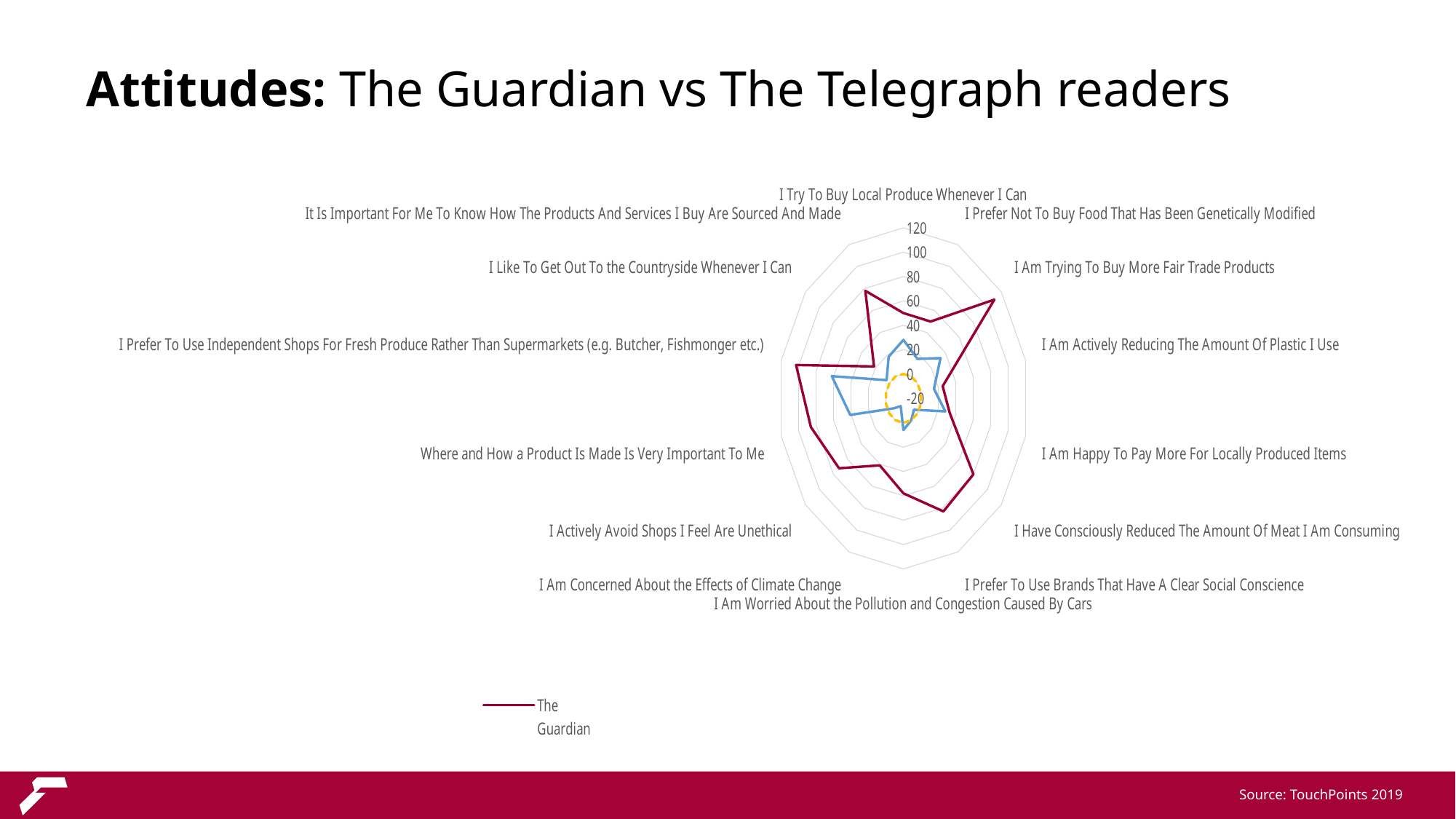
Is The Guardian value for "I Have Consciously Reduced The Amount Of Meat I Am Consuming" greater or less than 40? greater Is The Guardian value for "I Try To Buy Local Produce Whenever I Can" greater or less than 80? less Is The Guardian value for "I Am Worried About the Pollution and Congestion Caused By Cars" greater or less than 100? less What is the highest value shown on the radar chart's axis scale? 120 How many series does the legend list? 1 What kind of chart is shown on the slide? radar chart For The Guardian, which is larger: the value for "I Am Trying To Buy More Fair Trade Products" or the value for "I Try To Buy Local Produce Whenever I Can"? I Am Trying To Buy More Fair Trade Products Which series is named in the legend? The Guardian How many attitude statements (categories) are plotted on the radar chart? 14